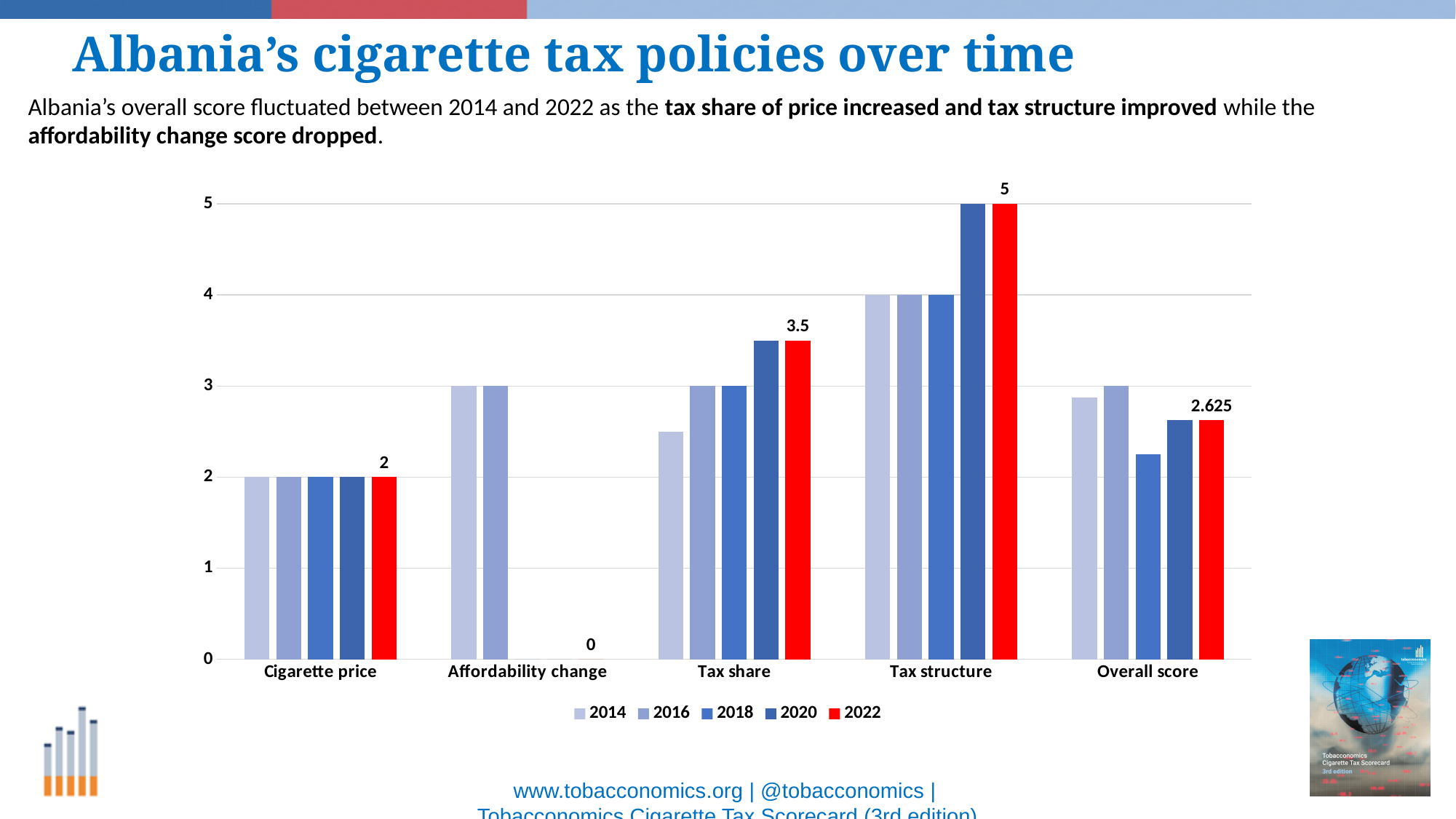
Do the Tax share values rise or fall from 2014 to 2022? rise Which category has the highest value for 2022? Tax structure Is the value for Tax share in 2014 greater or less than 3? less What is the value for Tax share in 2022? 3.5 What is the difference between the 2022 values for Tax structure and Tax share? 1.5 Which category has the lowest value for 2022? Affordability change How many series does the legend list? 5 How many categories are shown on the x axis? 5 What is the value for Affordability change in 2022? 0 What is the Overall score for 2022? 2.625 Which is larger in 2022: Tax share or Overall score? Tax share What kind of chart is shown on the slide? bar chart